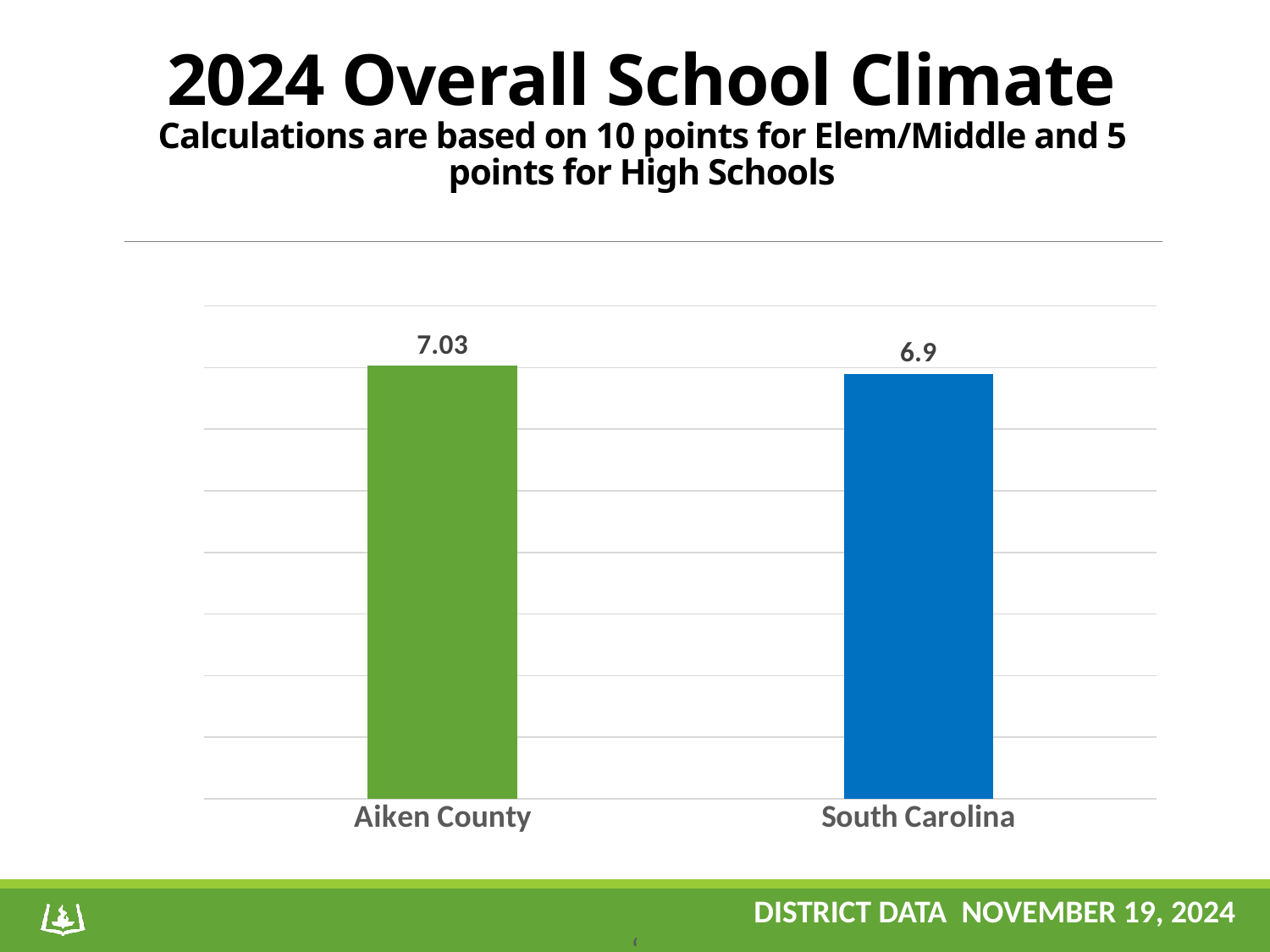
What is the title of the chart? 2024 Overall School Climate What is the value for Aiken County? 7.03 What is the value for South Carolina? 6.9 Which category has the higher value? Aiken County Which category has the lower value? South Carolina What is the difference between the Aiken County and South Carolina values? 0.13 What kind of chart is shown on the slide? bar chart What colour is the bar for Aiken County? green How many categories are shown in the chart? 2 Is the value for Aiken County larger or smaller than the value for South Carolina? larger